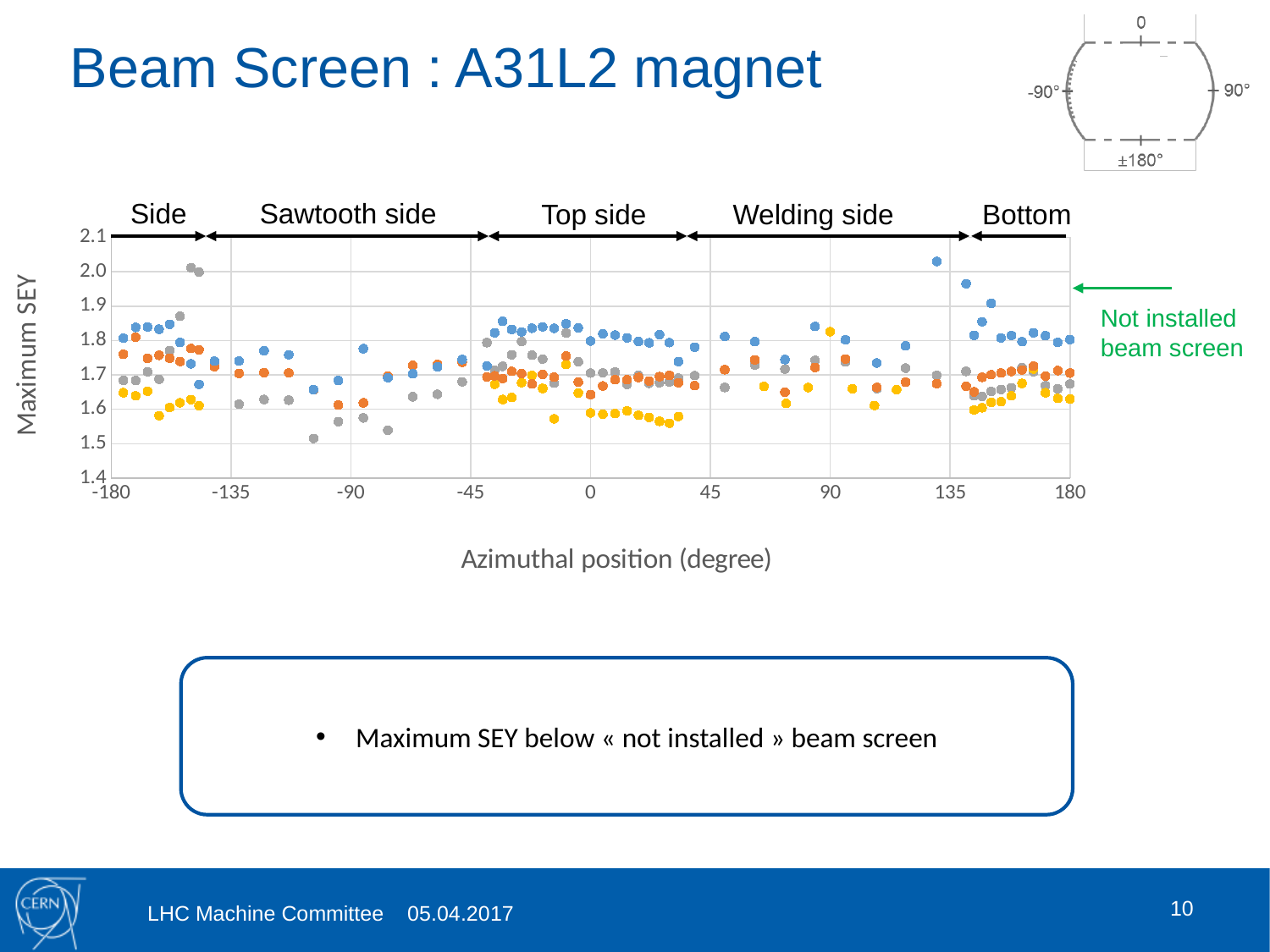
Is the value of the blue point at about 130 degrees greater or less than 2.0? greater Is the lowest gray point, at about -100 degrees, greater or less than 1.6? less What is the title of the x axis of the chart? Azimuthal position (degree) Is the lowest point plotted on the chart greater or less than 1.6? less What kind of chart is shown on the slide? scatter chart How many labelled regions (Side, Sawtooth side, etc.) are marked above the chart? 5